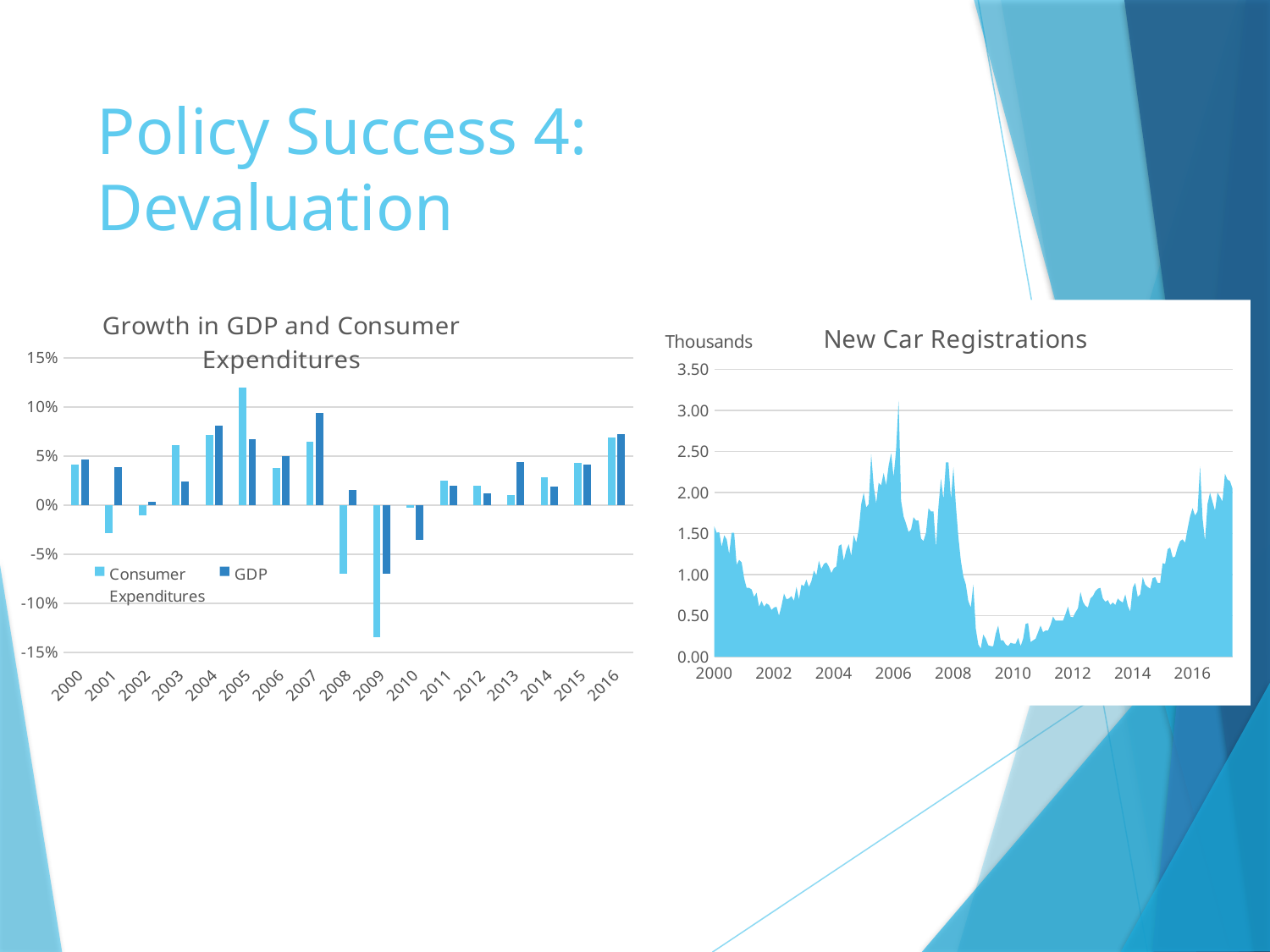
In the 'New Car Registrations' chart, is the peak value around 2006 greater or less than 3.00? greater How many series does the legend of the 'Growth in GDP and Consumer Expenditures' chart list? 2 What unit label is shown on the y axis of the 'New Car Registrations' chart? Thousands What kind of chart is the 'Growth in GDP and Consumer Expenditures' chart? bar chart In the 'Growth in GDP and Consumer Expenditures' chart, which year has the highest GDP growth? 2007 What kind of chart is the 'New Car Registrations' chart? area chart In the 'Growth in GDP and Consumer Expenditures' chart, is the Consumer Expenditures value for 2005 greater or less than 10%? greater In the 'Growth in GDP and Consumer Expenditures' chart, is the Consumer Expenditures value for 2009 greater or less than -10%? less In the 'Growth in GDP and Consumer Expenditures' chart, which year has the lowest Consumer Expenditures growth? 2009 In the 'Growth in GDP and Consumer Expenditures' chart, which is larger in 2008: Consumer Expenditures or GDP? GDP In the 'Growth in GDP and Consumer Expenditures' chart, which year has the highest Consumer Expenditures growth? 2005 How many years are shown on the x axis of the 'Growth in GDP and Consumer Expenditures' chart? 17